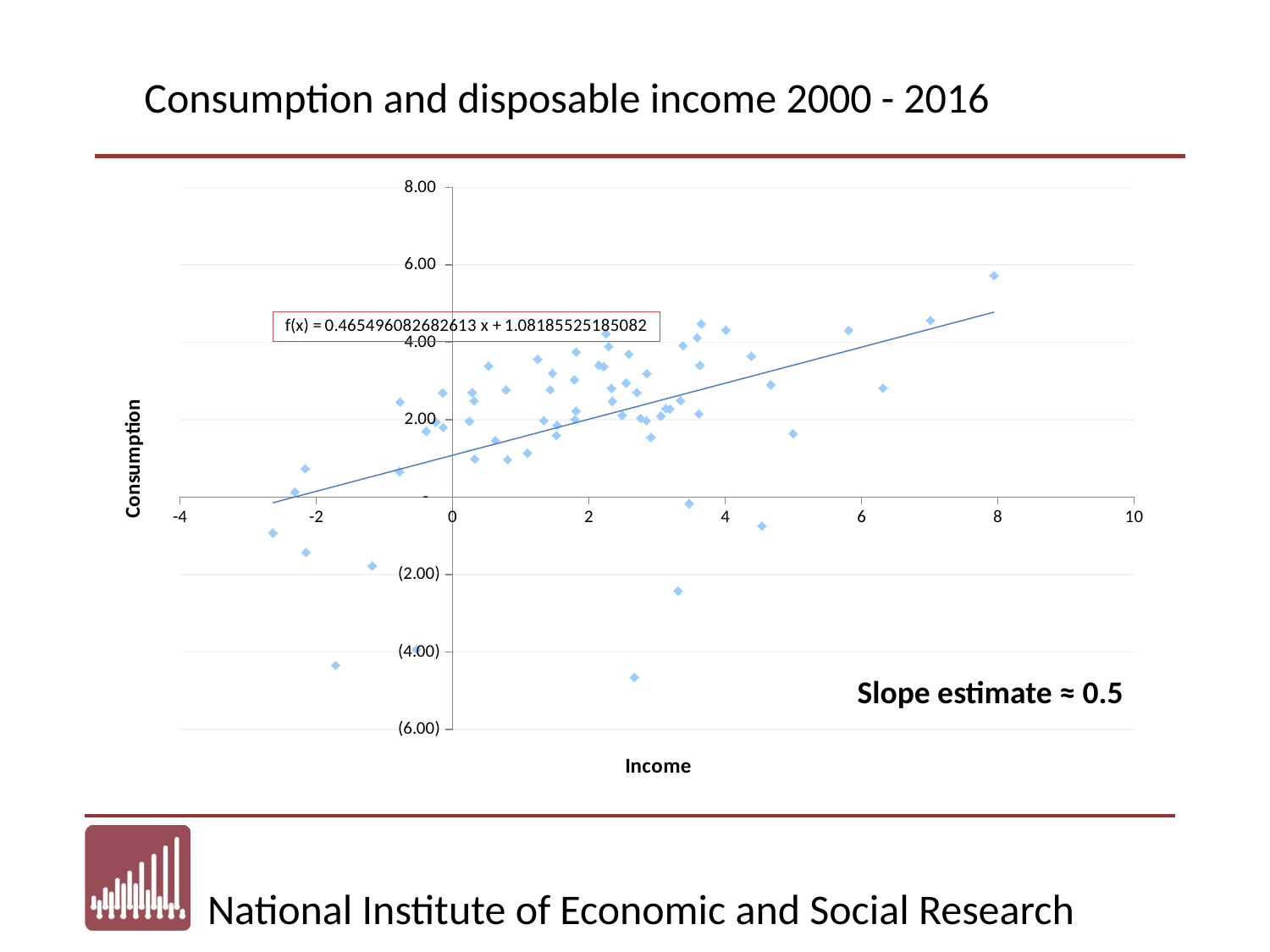
What is the title of the x axis? Income What is the title of the y axis? Consumption What is the slope coefficient shown in the fitted line equation f(x)? 0.465496082682613 Is the consumption value of the lowest point on the chart greater or less than (2.00)? less What is the intercept shown in the fitted line equation f(x)? 1.08185525185082 What approximate slope estimate is stated in the text on the chart? ≈ 0.5 As income increases along the x axis, does consumption tend to rise or fall according to the fitted line? rise What kind of chart is shown on the slide? scatter chart Is the income value of the point furthest to the right greater or less than 6? greater Is the consumption value of the highest point on the chart greater or less than 4.00? greater